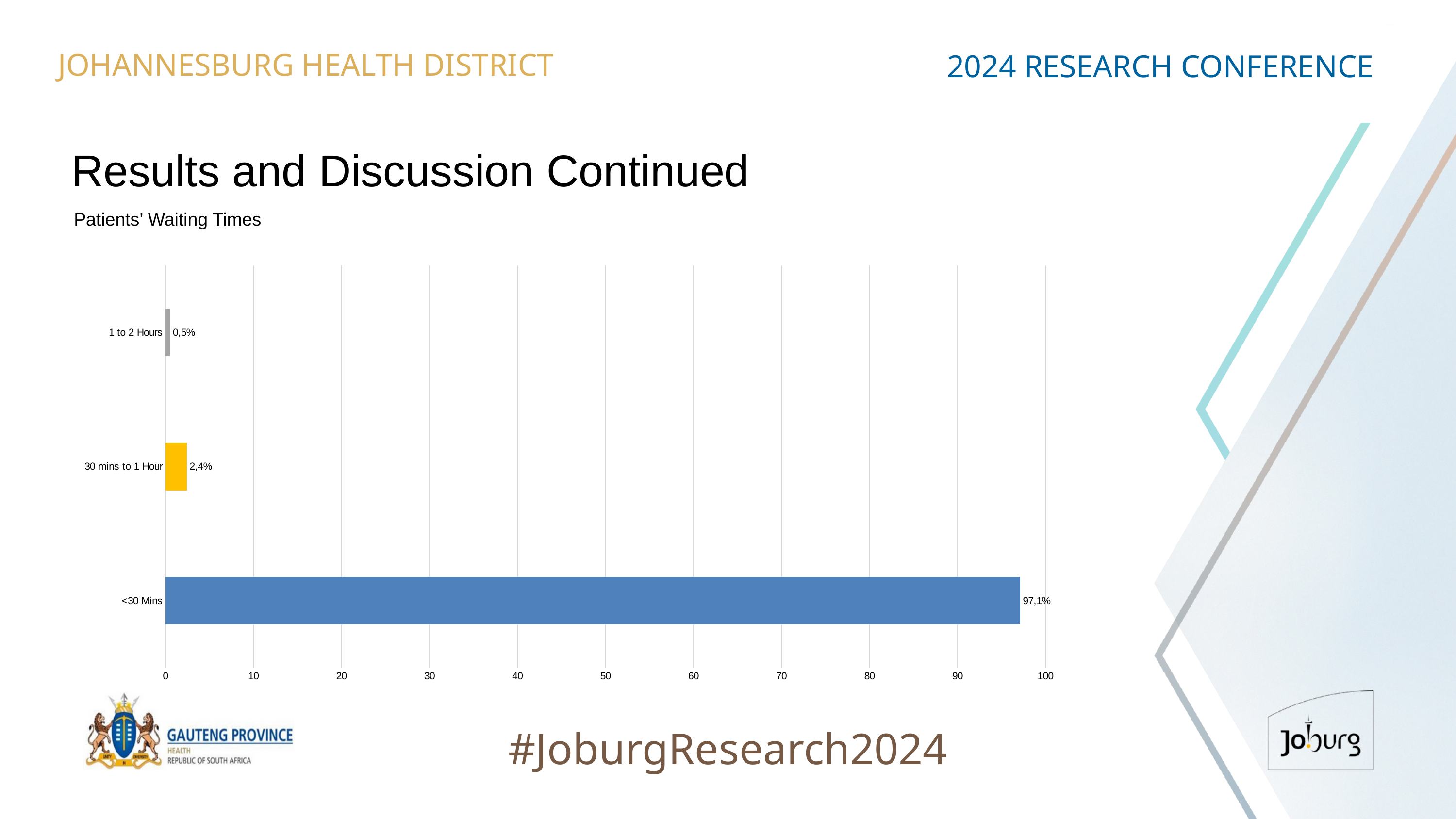
What is the value for 1 to 2 Hours? 0,5% Which is larger, the value for 30 mins to 1 Hour or the value for 1 to 2 Hours? 30 mins to 1 Hour Is the value for <30 Mins greater or less than 90? greater What is the difference between the values for 30 mins to 1 Hour and 1 to 2 Hours? 1,9% What is the value for <30 Mins? 97,1% How many waiting time categories are shown in the chart? 3 Which waiting time category has the highest value? <30 Mins What is the value for 30 mins to 1 Hour? 2,4% What is the difference between the values for <30 Mins and 30 mins to 1 Hour? 94,7% Which waiting time category has the lowest value? 1 to 2 Hours What is the title of the chart? Patients' Waiting Times What kind of chart is shown on the slide? Bar chart